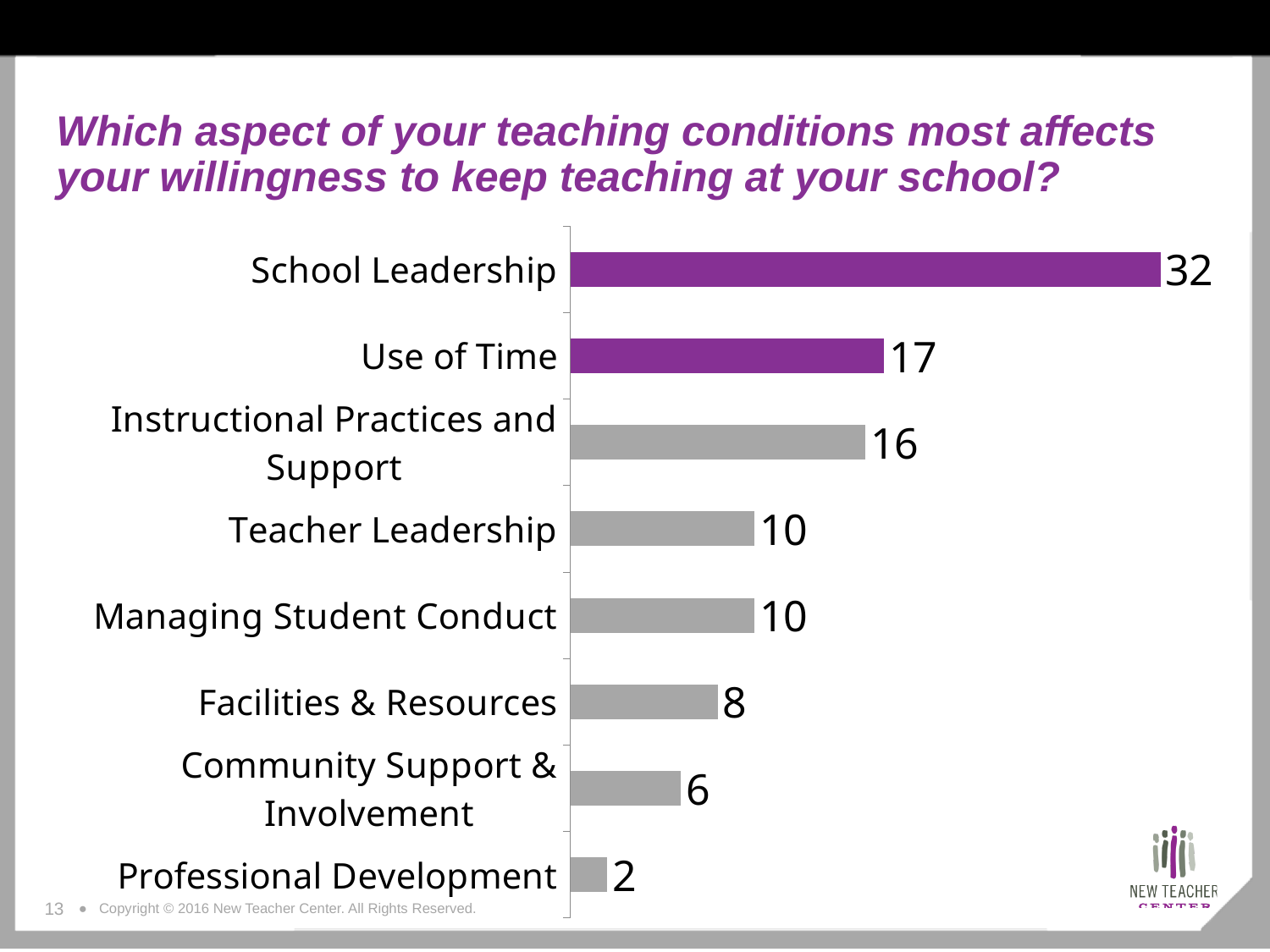
Which two categories are shown with purple bars? School Leadership and Use of Time What is the value for Instructional Practices and Support? 16 Which category has the highest value? School Leadership What is the value for Use of Time? 17 Which is larger, the value for Teacher Leadership or the value for Facilities & Resources? Teacher Leadership How many categories are shown in the chart? 8 What is the value for Community Support & Involvement? 6 What is the value for School Leadership? 32 What kind of chart is shown on the slide? Bar chart What is the difference between the values for School Leadership and Use of Time? 15 Which category has the lowest value? Professional Development What is the difference between the values for Facilities & Resources and Professional Development? 6